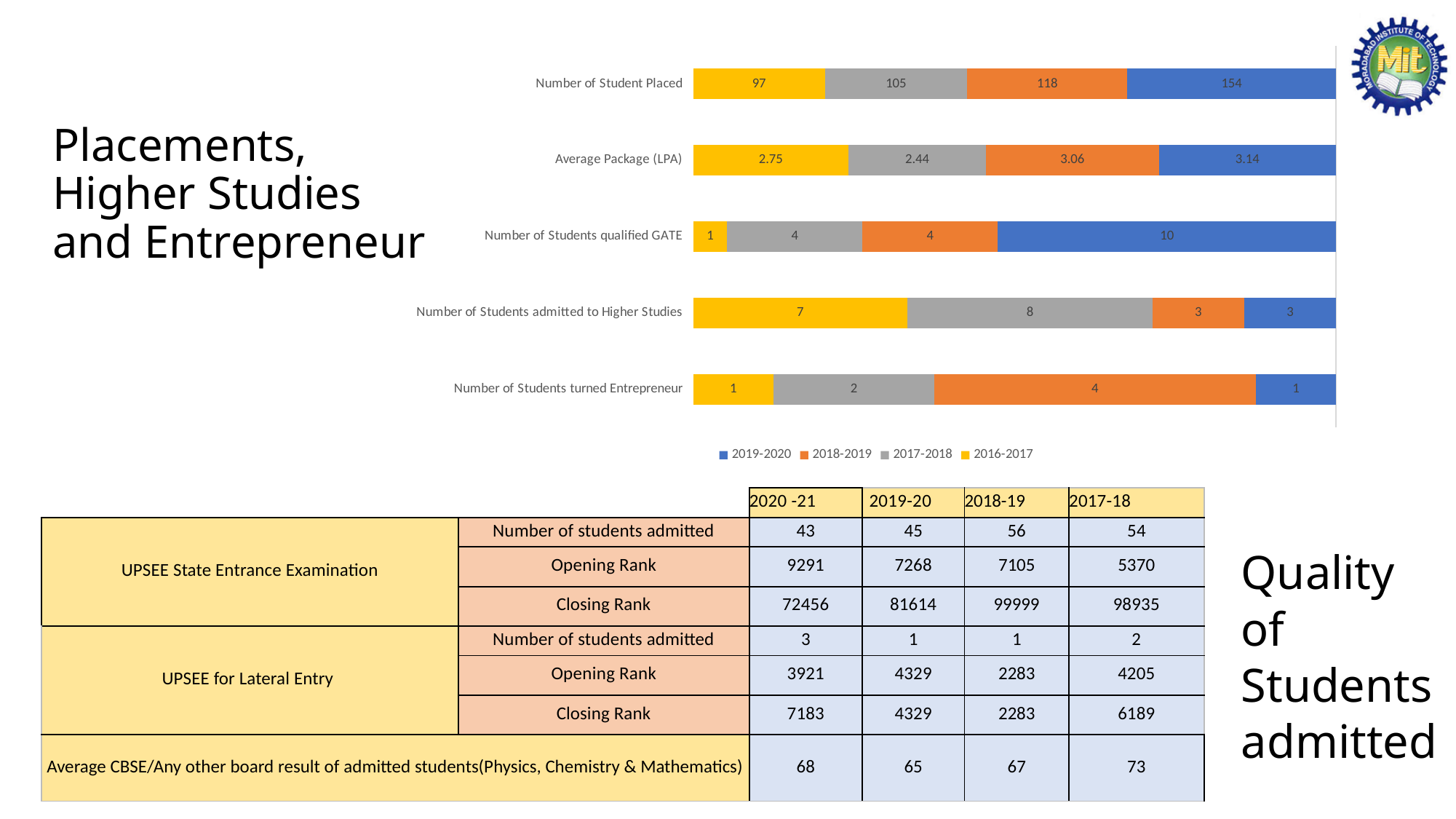
What type of chart is shown at the top of the slide? Stacked bar chart In the stacked bar chart, which year had more students admitted to Higher Studies, 2016-2017 or 2017-2018? 2017-2018 In the stacked bar chart, what is the total Number of Students turned Entrepreneur across all four years? 8 In the stacked bar chart, what is the difference between the Number of Student Placed in 2019-2020 and in 2016-2017? 57 In the stacked bar chart, how many students qualified GATE in 2019-2020? 10 In the stacked bar chart, which year has the lowest Average Package (LPA)? 2017-2018 In the stacked bar chart, which year has the highest Number of Student Placed? 2019-2020 How many series does the legend of the stacked bar chart list? 4 In the stacked bar chart, what is the Number of Student Placed for 2019-2020? 154 How many categories are shown on the vertical axis of the stacked bar chart? 5 In the stacked bar chart, what is the Average Package (LPA) for 2016-2017? 2.75 In the stacked bar chart, how many students were admitted to Higher Studies in 2017-2018? 8